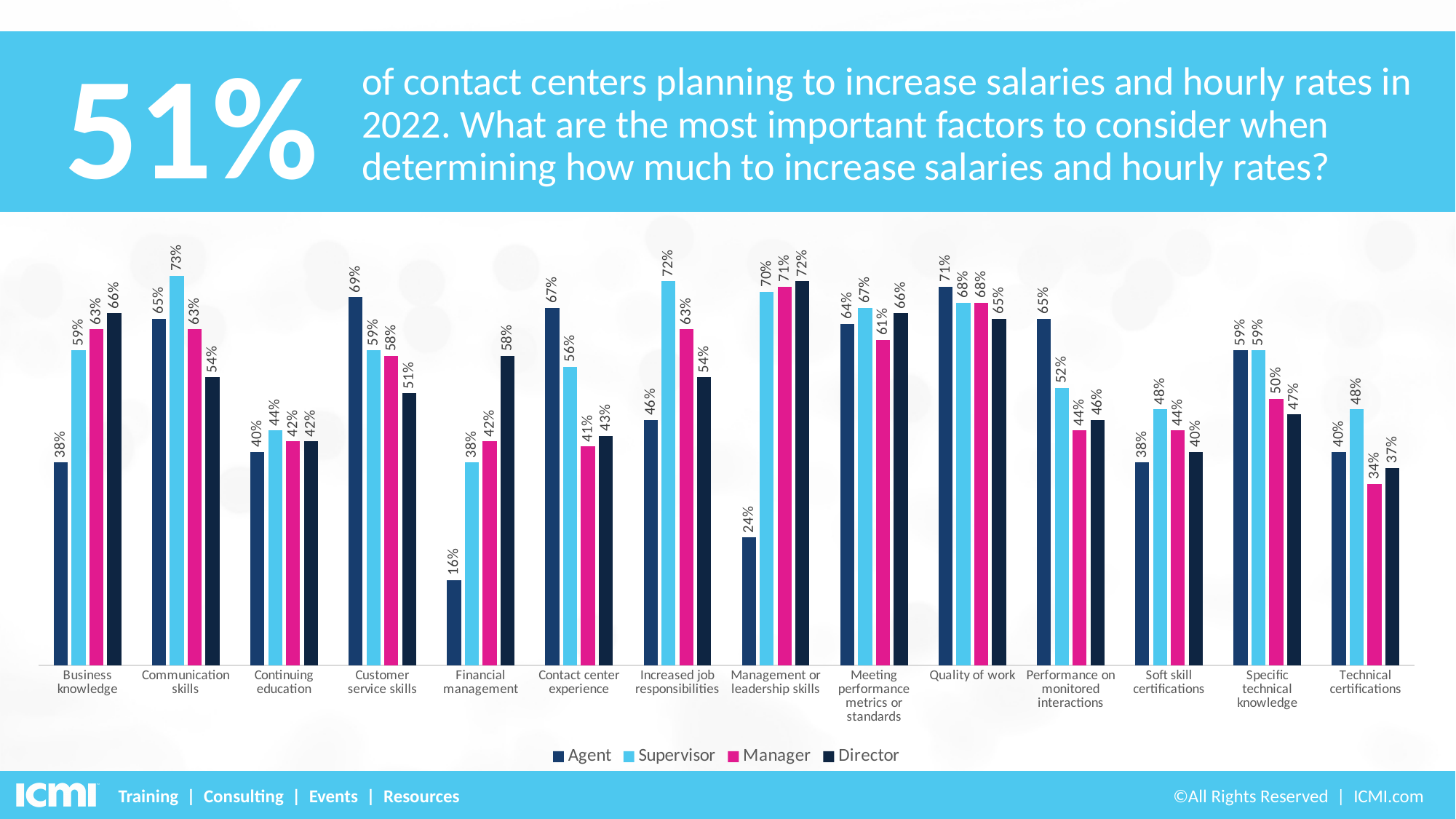
What is the Agent value for Financial management? 16% Which category has the lowest Agent value? Financial management How many series does the legend list? 4 What is the difference between the Supervisor and Agent values for Management or leadership skills? 46% How many categories are shown on the x axis? 14 What kind of chart is shown on the slide? Bar chart Which category has the lowest Manager value? Technical certifications What is the Supervisor value for Communication skills? 73% What is the Director value for Management or leadership skills? 72% Which category has the highest Agent value? Quality of work Which is larger for Contact center experience, the Agent value or the Director value? Agent What is the Manager value for Technical certifications? 34%